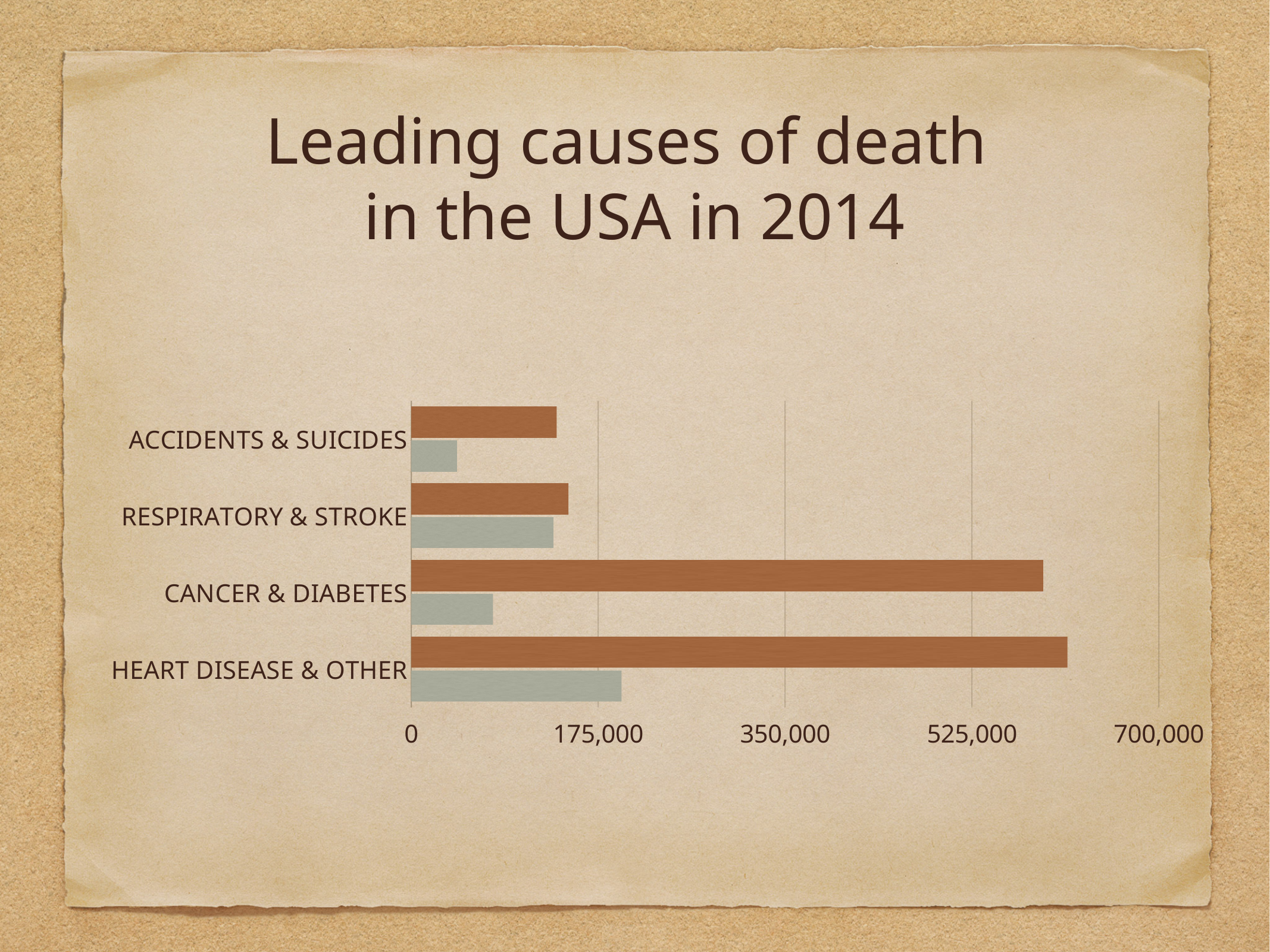
Which category has the longest brown bar? HEART DISEASE & OTHER How many categories are shown on the chart? 4 For CANCER & DIABETES, which bar is longer, the brown bar or the grey bar? The brown bar Which grey bar is longer, HEART DISEASE & OTHER or RESPIRATORY & STROKE? HEART DISEASE & OTHER Is the brown bar for ACCIDENTS & SUICIDES greater or less than 175,000? less Which category has the shortest grey bar? ACCIDENTS & SUICIDES What kind of chart is shown on the slide? Bar chart Is the brown bar for CANCER & DIABETES greater or less than 525,000? greater Is the grey bar for CANCER & DIABETES greater or less than 175,000? less What is the title of the slide? Leading causes of death in the USA in 2014 Which category has the longest grey bar? HEART DISEASE & OTHER